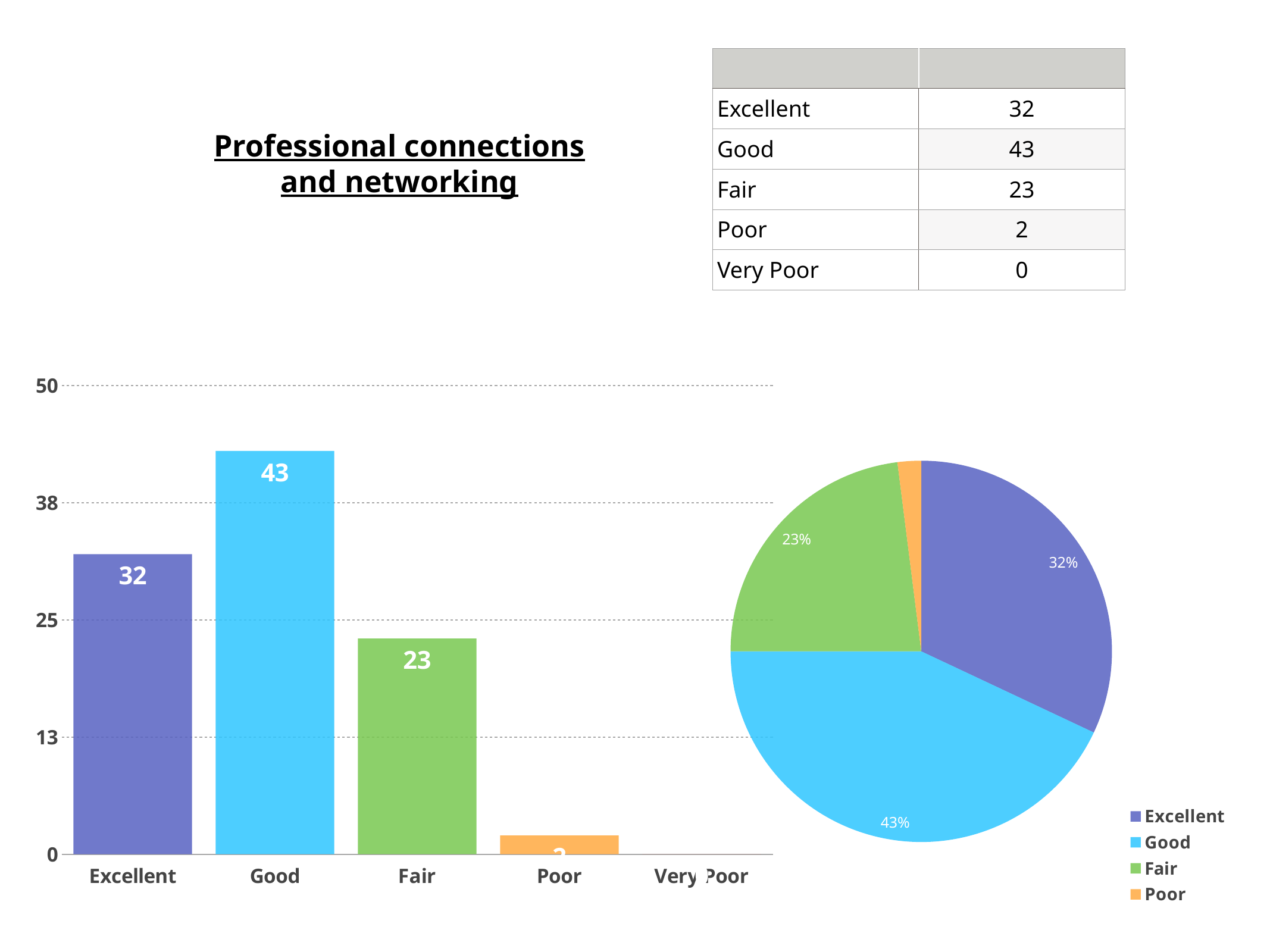
In the bar chart, what is the value for Excellent? 32 In the bar chart, what is the difference between the values for Good and Excellent? 11 In the bar chart, which category has the lowest value? Very Poor In the pie chart, what share does the Good slice have? 43% In the bar chart, which is larger, the value for Excellent or the value for Fair? Excellent In the bar chart, what is the value for Good? 43 In the bar chart, what is the value for Fair? 23 What kind of chart is on the right of the slide? pie chart How many categories are shown on the x axis of the bar chart? 5 In the bar chart, is the value for Poor greater or less than 13? less In the bar chart, which category has the highest value? Good What kind of chart is on the left of the slide? bar chart